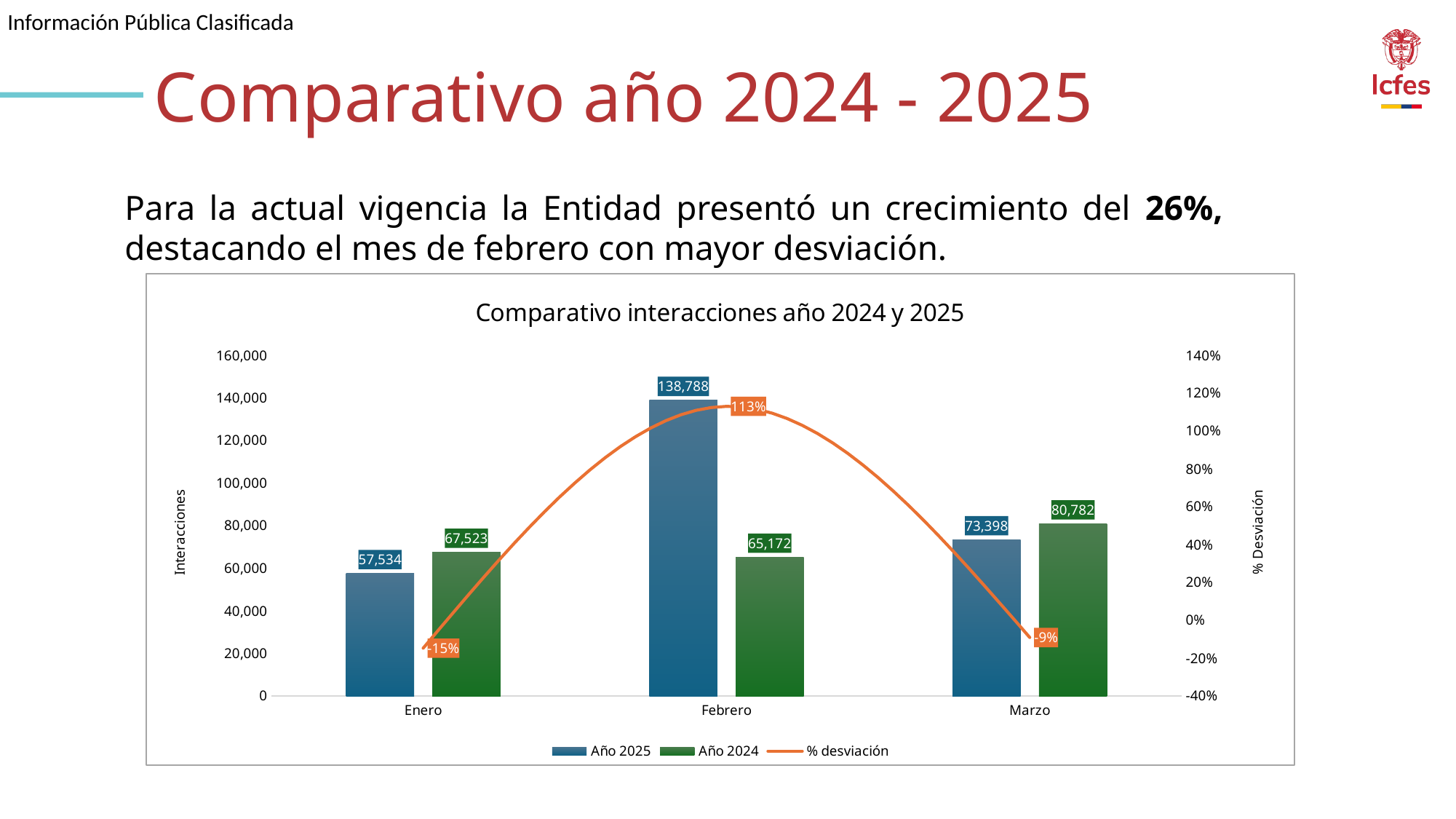
What is the difference between Año 2025 and Año 2024 in Febrero? 73,616 Which is larger in Marzo, Año 2025 or Año 2024? Año 2024 How many months are shown on the x axis? 3 What is the value for Año 2025 in Febrero? 138,788 Which month has the highest value for Año 2025? Febrero What is the title of the chart? Comparativo interacciones año 2024 y 2025 What is the value for Año 2024 in Enero? 67,523 What kind of chart is used for the Año 2025 and Año 2024 series? Bar chart What is the value for Año 2025 in Marzo? 73,398 Which month has the lowest value for Año 2024? Febrero What is the % desviación for Marzo? -9% How many series does the legend list? 3